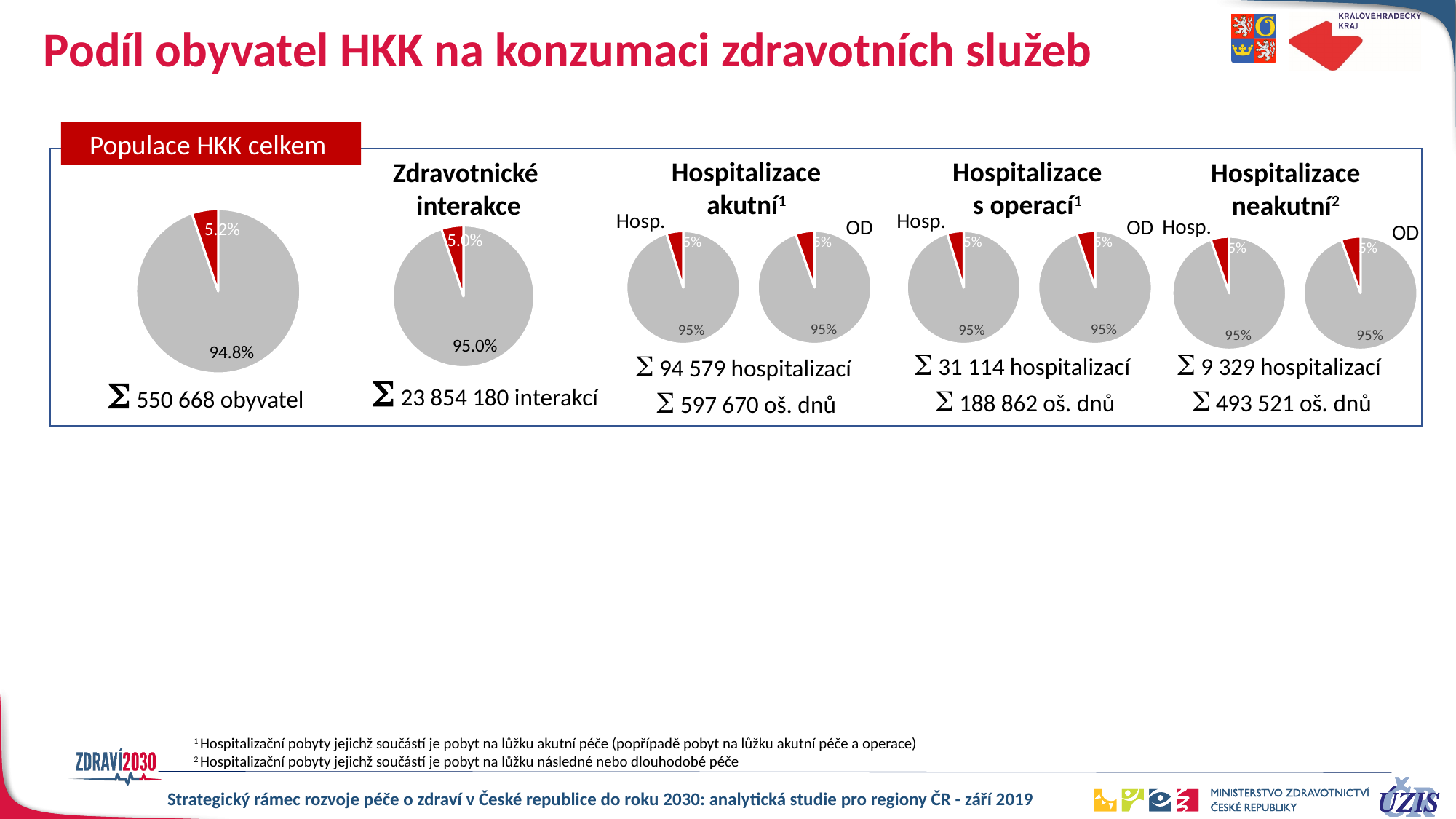
In the 'Populace HKK celkem' pie chart, what share does the red slice represent? 5.2% What colour is the smaller slice in the 'Hospitalizace neakutní' OD pie chart? Red In the 'Populace HKK celkem' pie chart, what share does the grey slice represent? 94.8% What total is printed below the 'Populace HKK celkem' pie chart? 550 668 obyvatel How many slices does the 'Populace HKK celkem' pie chart have? 2 What kind of chart is used for 'Populace HKK celkem'? Pie chart What total number of interactions is printed below the 'Zdravotnické interakce' pie chart? 23 854 180 interakcí How many pie charts are shown under the heading 'Hospitalizace s operací'? 2 In the 'Hospitalizace akutní' Hosp. pie chart, what share does the grey slice represent? 95% In the 'Populace HKK celkem' pie chart, which slice is larger, the red one or the grey one? The grey one In the 'Zdravotnické interakce' pie chart, what is the value of the red slice? 5.0% In the 'Zdravotnické interakce' pie chart, what is the value of the larger (grey) slice? 95.0%